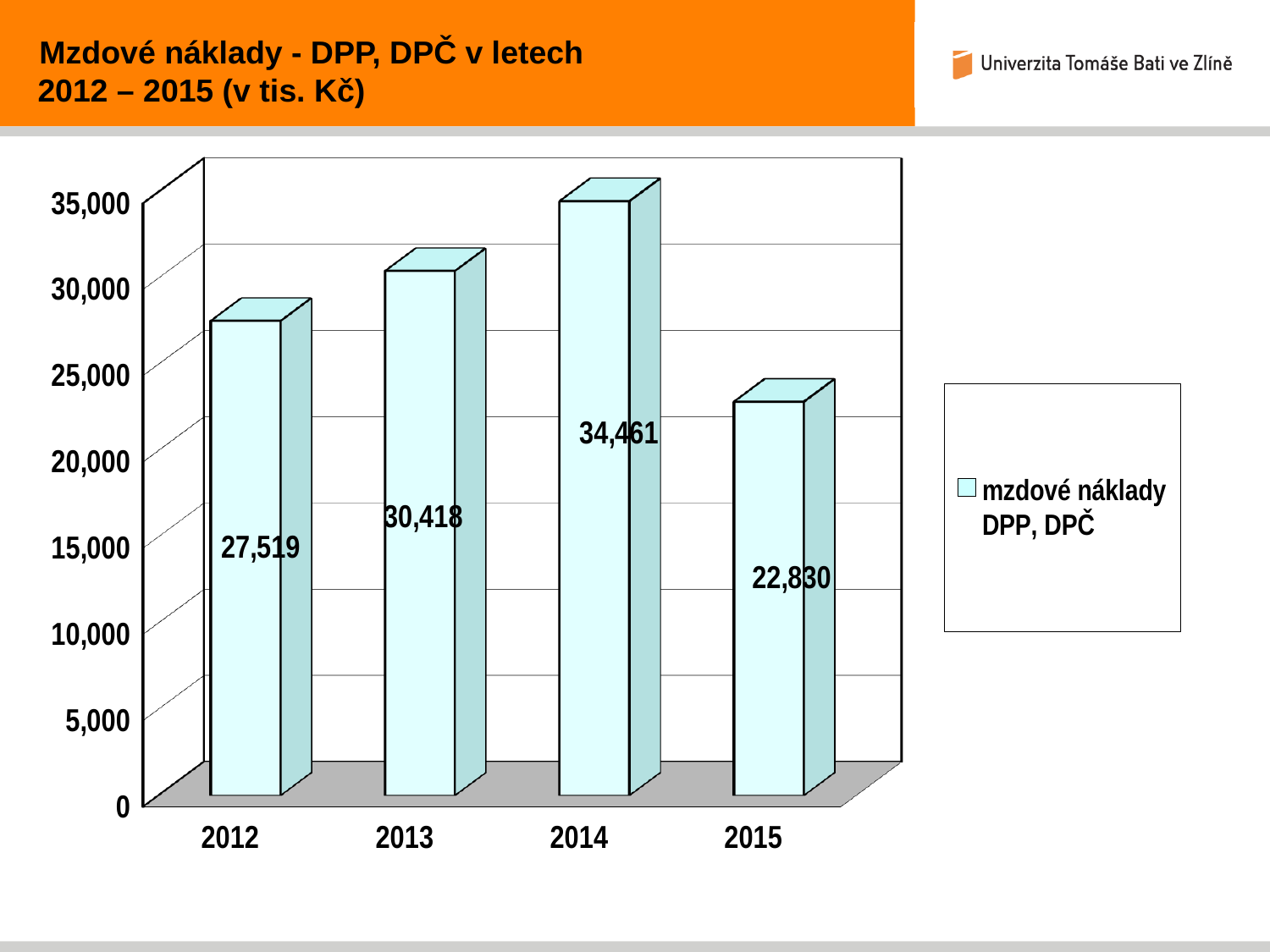
What kind of chart is shown on the slide? bar chart How many years are shown on the x axis? 4 What is the difference between the values for 2014 and 2015? 11,631 What is the difference between the values for 2013 and 2012? 2,899 What series name does the legend list? mzdové náklady DPP, DPČ What is the value for 2015? 22,830 Which year has the highest value? 2014 Is the value for 2013 greater or less than 30,000? greater Which is larger, the value for 2013 or the value for 2015? 2013 What is the value for 2012? 27,519 What is the value for 2014? 34,461 Which year has the lowest value? 2015